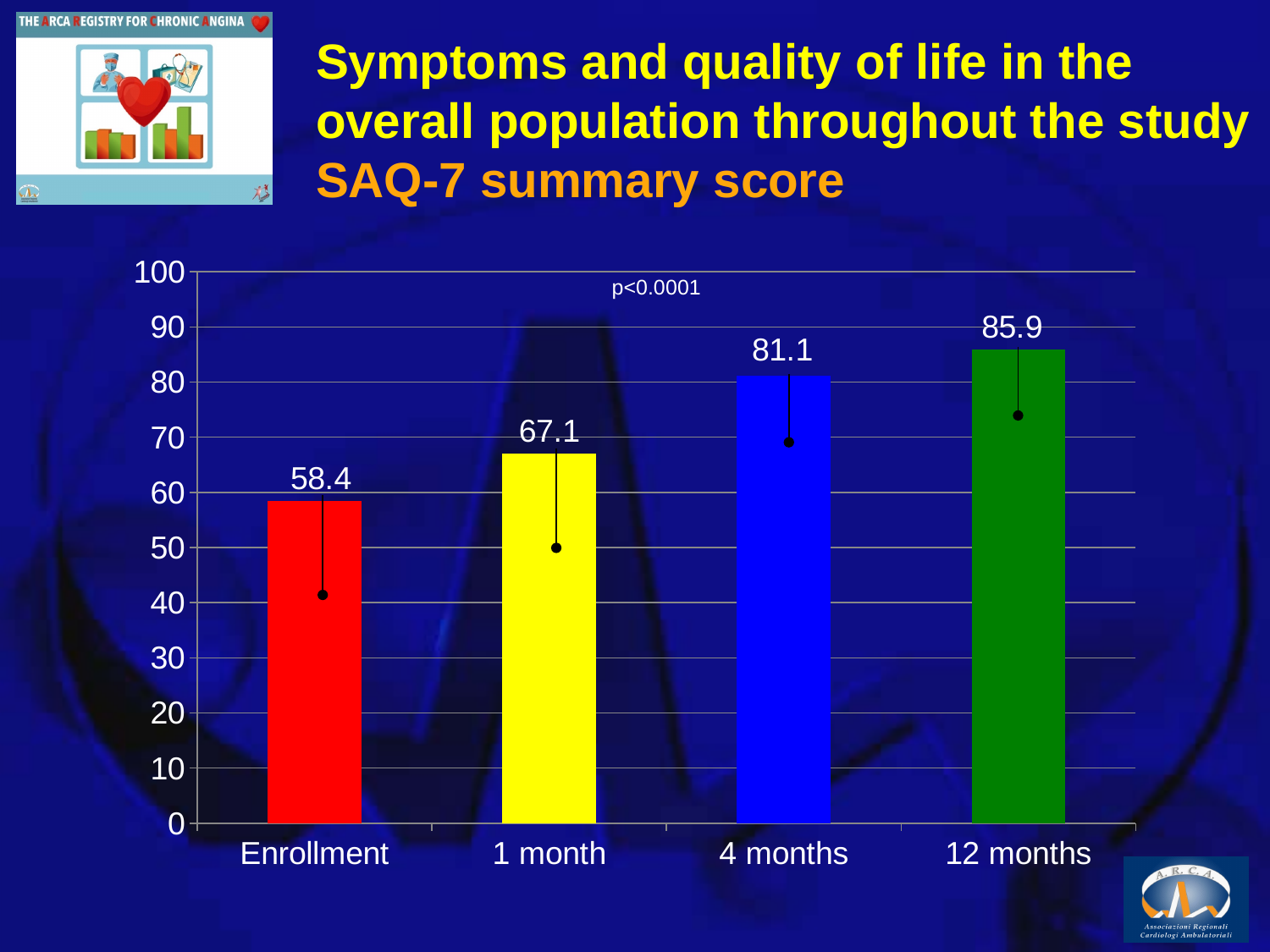
What is the SAQ-7 summary score at 4 months? 81.1 Which time point has the highest SAQ-7 summary score? 12 months Which time point has the lowest SAQ-7 summary score? Enrollment Do the SAQ-7 summary scores rise or fall from Enrollment to 12 months? Rise What is the difference between the SAQ-7 summary score at 12 months and at Enrollment? 27.5 What p-value is printed on the chart? p<0.0001 How many time points are shown on the chart? 4 What is the SAQ-7 summary score at Enrollment? 58.4 What is the SAQ-7 summary score at 1 month? 67.1 Which is larger, the SAQ-7 summary score at 1 month or at 4 months? 4 months What kind of chart is shown on the slide? Bar chart What is the SAQ-7 summary score at 12 months? 85.9